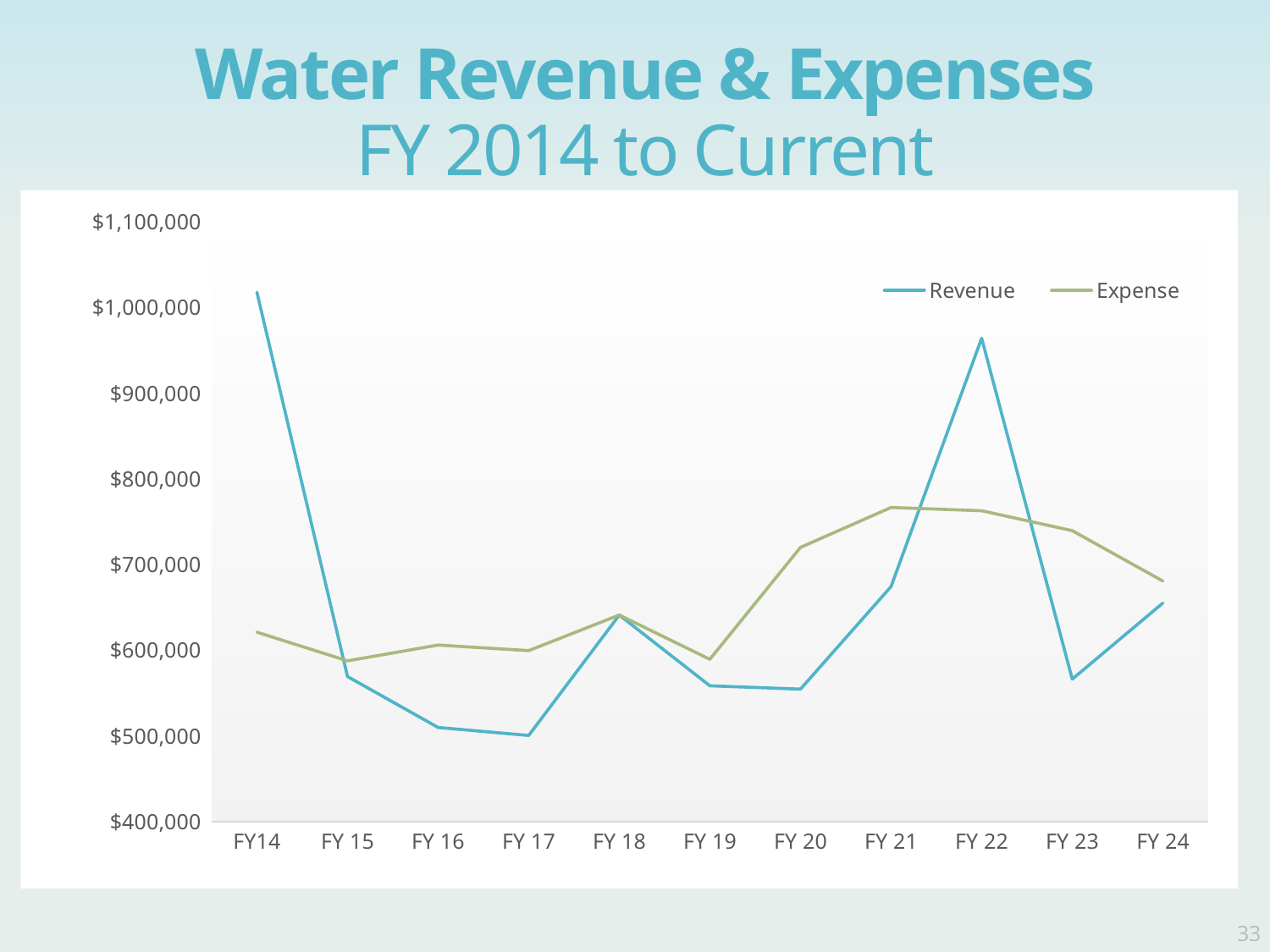
Does Revenue rise or fall from FY14 to FY17? fall Is the Revenue value for FY22 greater or less than $900,000? greater In which fiscal year is Revenue highest? FY14 Is the Revenue value for FY14 greater or less than $1,000,000? greater What kind of chart is shown on the slide? line chart What are the two series named in the legend? Revenue and Expense In FY22, which is larger, Revenue or Expense? Revenue How many fiscal years are plotted along the x axis? 11 In FY20, which is larger, Revenue or Expense? Expense How many series does the legend list? 2 Is the Revenue value for FY17 greater or less than $600,000? less